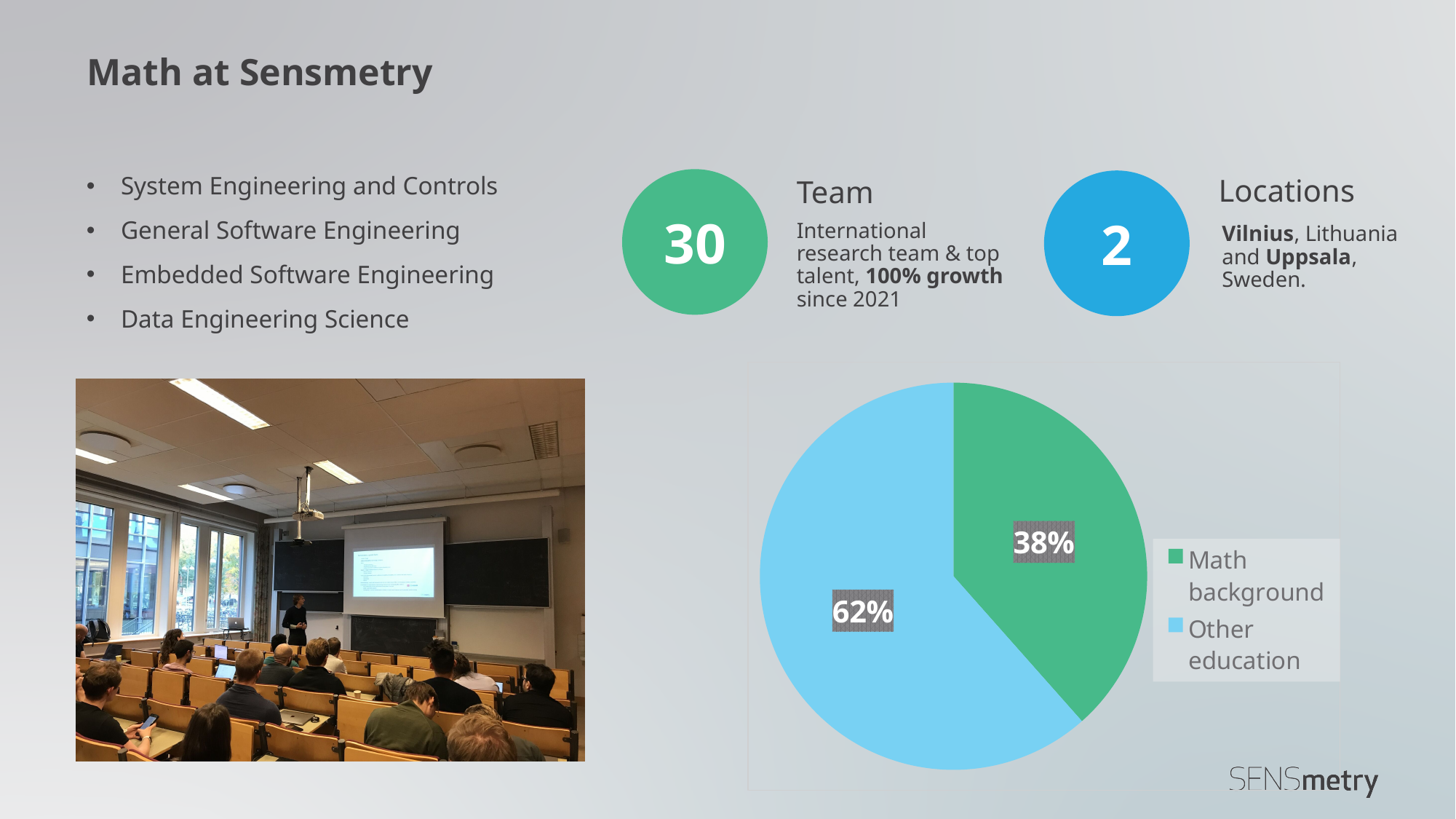
Which slice of the pie chart is the largest? Other education Which is larger in the pie chart, "Math background" or "Other education"? Other education How many slices does the pie chart have? 2 What share of the pie does "Math background" represent? 38% How many entries does the legend of the pie chart list? 2 What kind of chart is shown on the slide? pie chart Which slice of the pie chart is the smallest? Math background What is the difference in percentage points between "Other education" and "Math background"? 24 What colour is the "Other education" slice in the pie chart? light blue What colour is the "Math background" slice in the pie chart? green What share of the pie does "Other education" represent? 62%